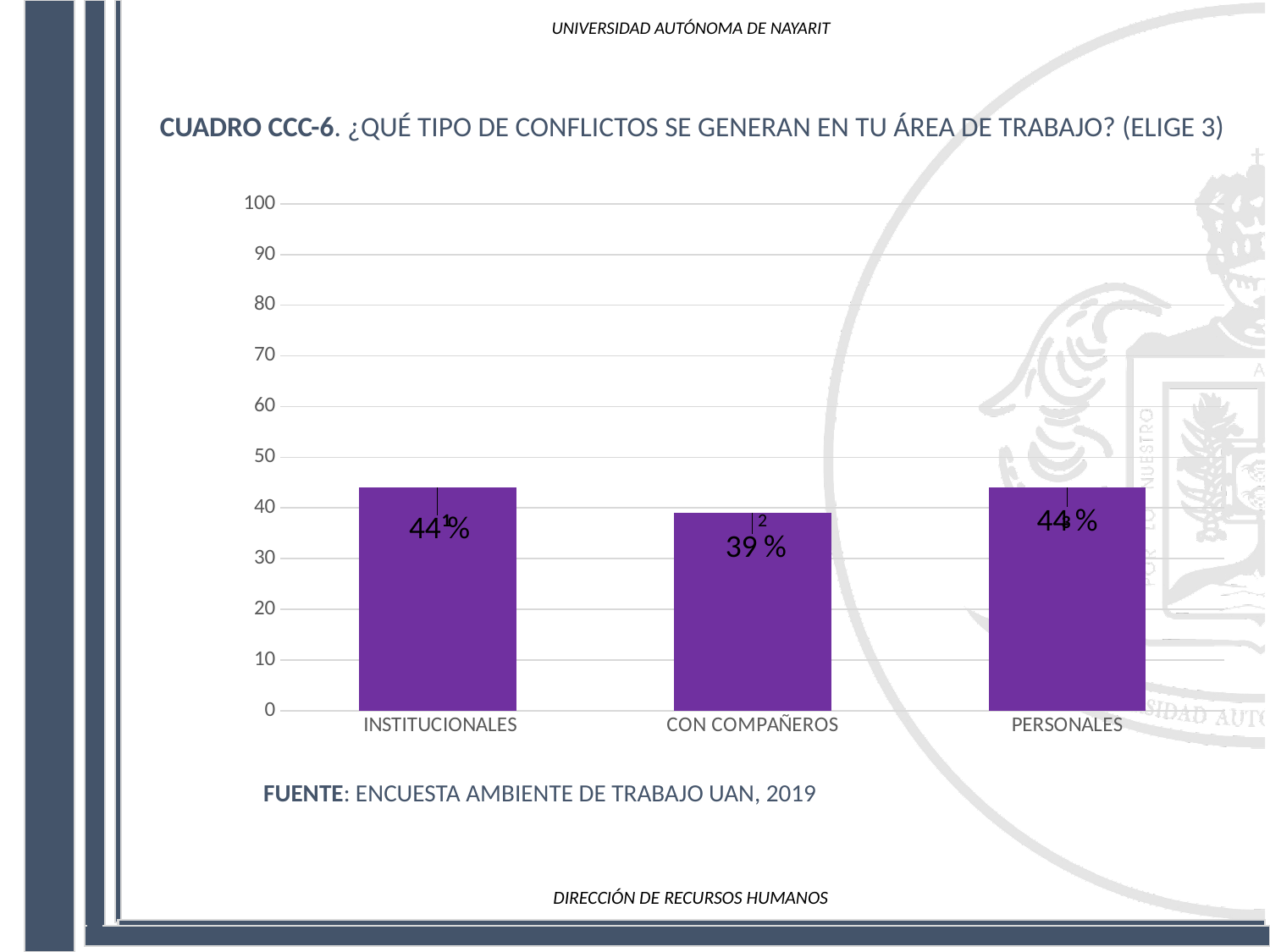
What kind of chart is shown on the slide? bar chart Which is larger, the value for PERSONALES or the value for CON COMPAÑEROS? PERSONALES What is the highest value shown on the vertical axis? 100 Is the value for INSTITUCIONALES greater or less than 40? greater Is the value for CON COMPAÑEROS greater or less than 50? less What source is cited below the chart? ENCUESTA AMBIENTE DE TRABAJO UAN, 2019 What is the value for INSTITUCIONALES? 44 % What is the value for CON COMPAÑEROS? 39 % Which category has the lowest value? CON COMPAÑEROS What is the difference between the values for INSTITUCIONALES and CON COMPAÑEROS? 5 percentage points How many categories are shown on the x axis? 3 What is the value for PERSONALES? 44 %